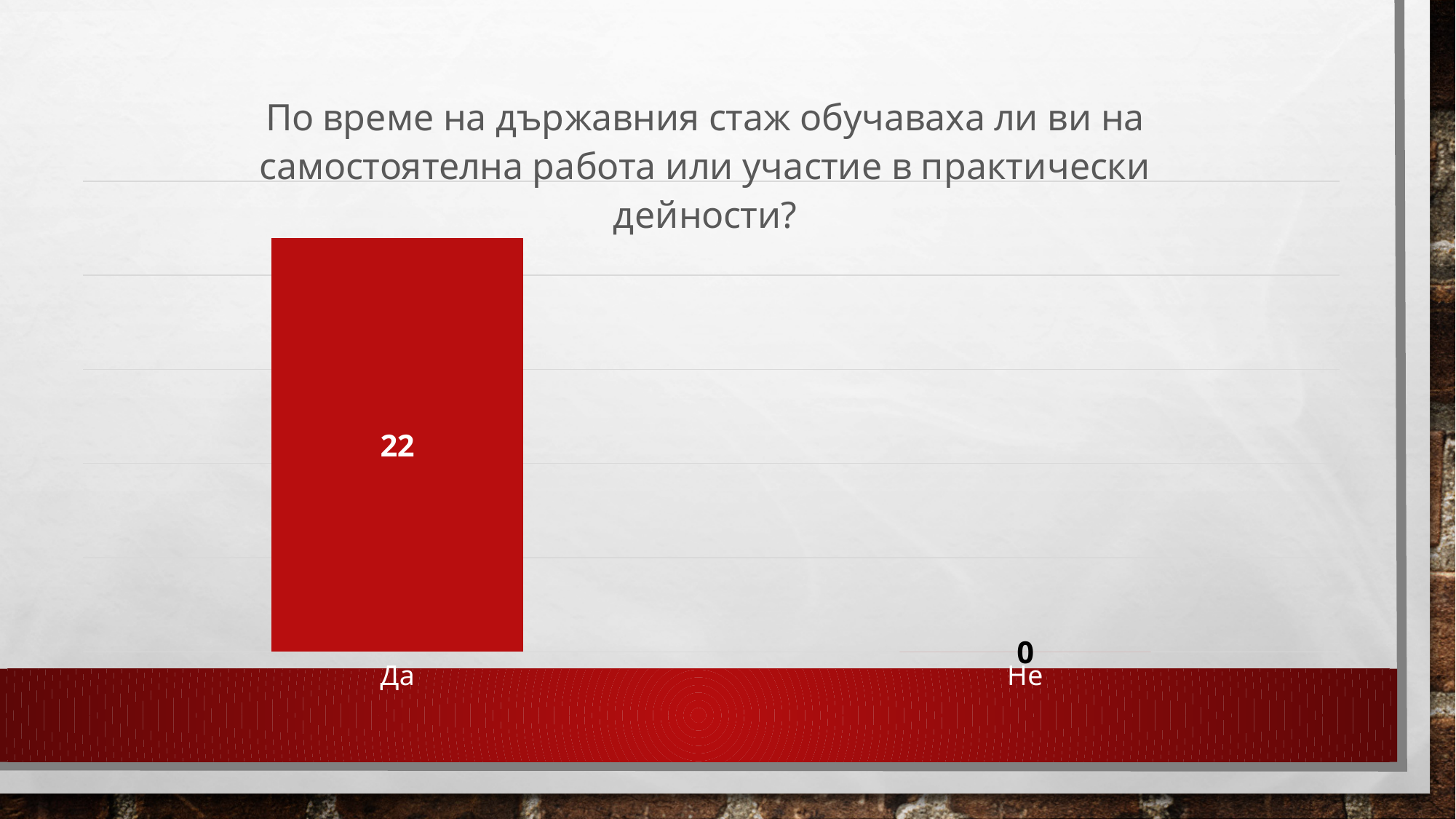
What is the total of the values for "Да" and "Не"? 22 What kind of chart is shown on the slide? bar chart What is the difference between the values for "Да" and "Не"? 22 What is the title of the chart? По време на държавния стаж обучаваха ли ви на самостоятелна работа или участие в практически дейности? Which is larger, the value for "Да" or the value for "Не"? Да What is the value for "Не"? 0 Which category has the highest value? Да What is the value for "Да"? 22 How many categories are shown in the chart? 2 What colour is the bar for "Да"? red Which category has the lowest value? Не